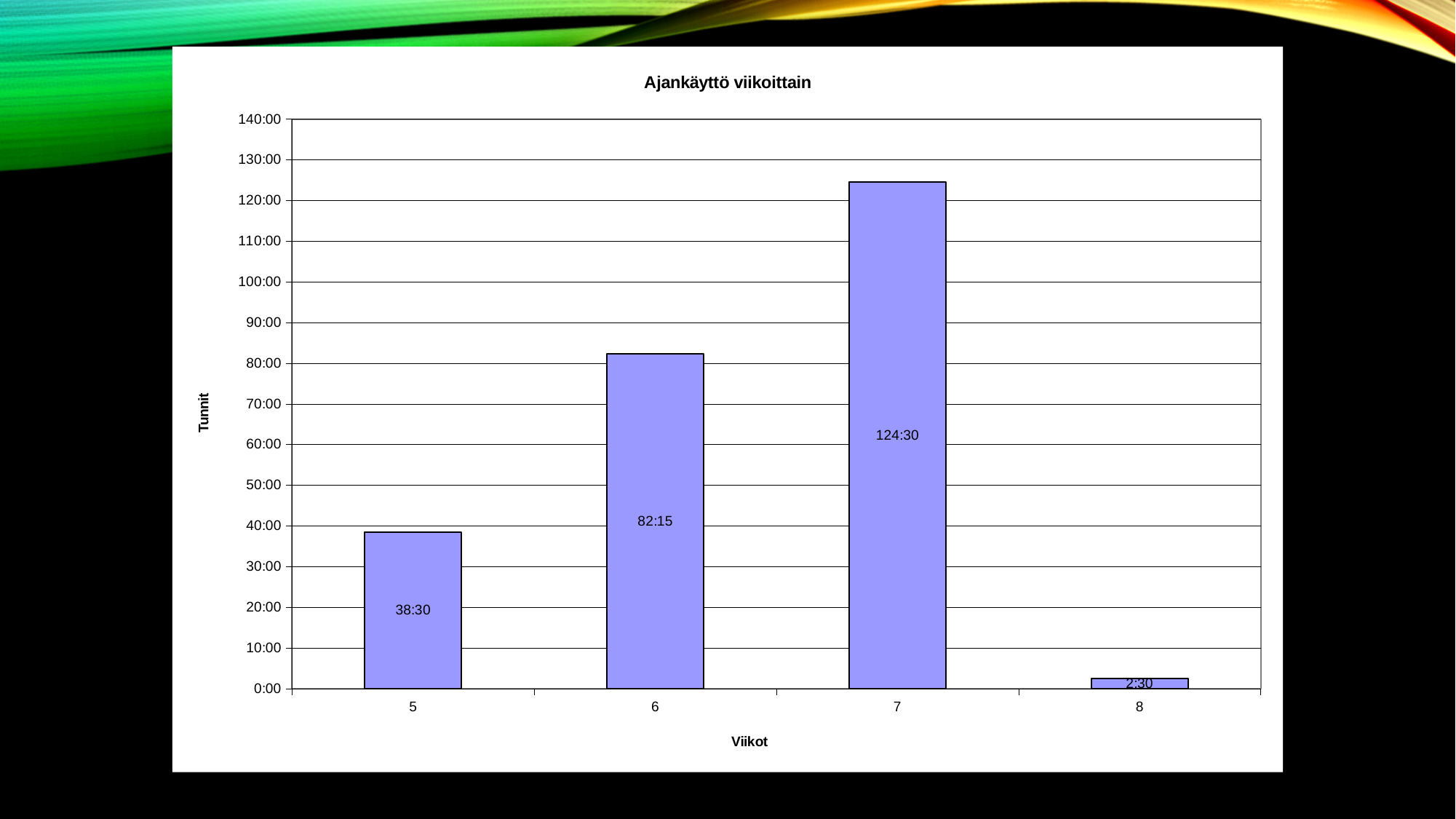
How many weeks are shown on the x axis? 4 Is the value for week 6 greater or less than 80:00? greater What is the value for week 7? 124:30 Which is larger, the value for week 6 or the value for week 5? week 6 What is the difference between the values for week 5 and week 8? 36:00 What is the value for week 5? 38:30 Which week has the lowest value? 8 What is the difference between the values for week 7 and week 6? 42:15 What is the value for week 8? 2:30 What kind of chart is this? bar chart Which week has the highest value? 7 What is the title of the chart? Ajankäyttö viikoittain